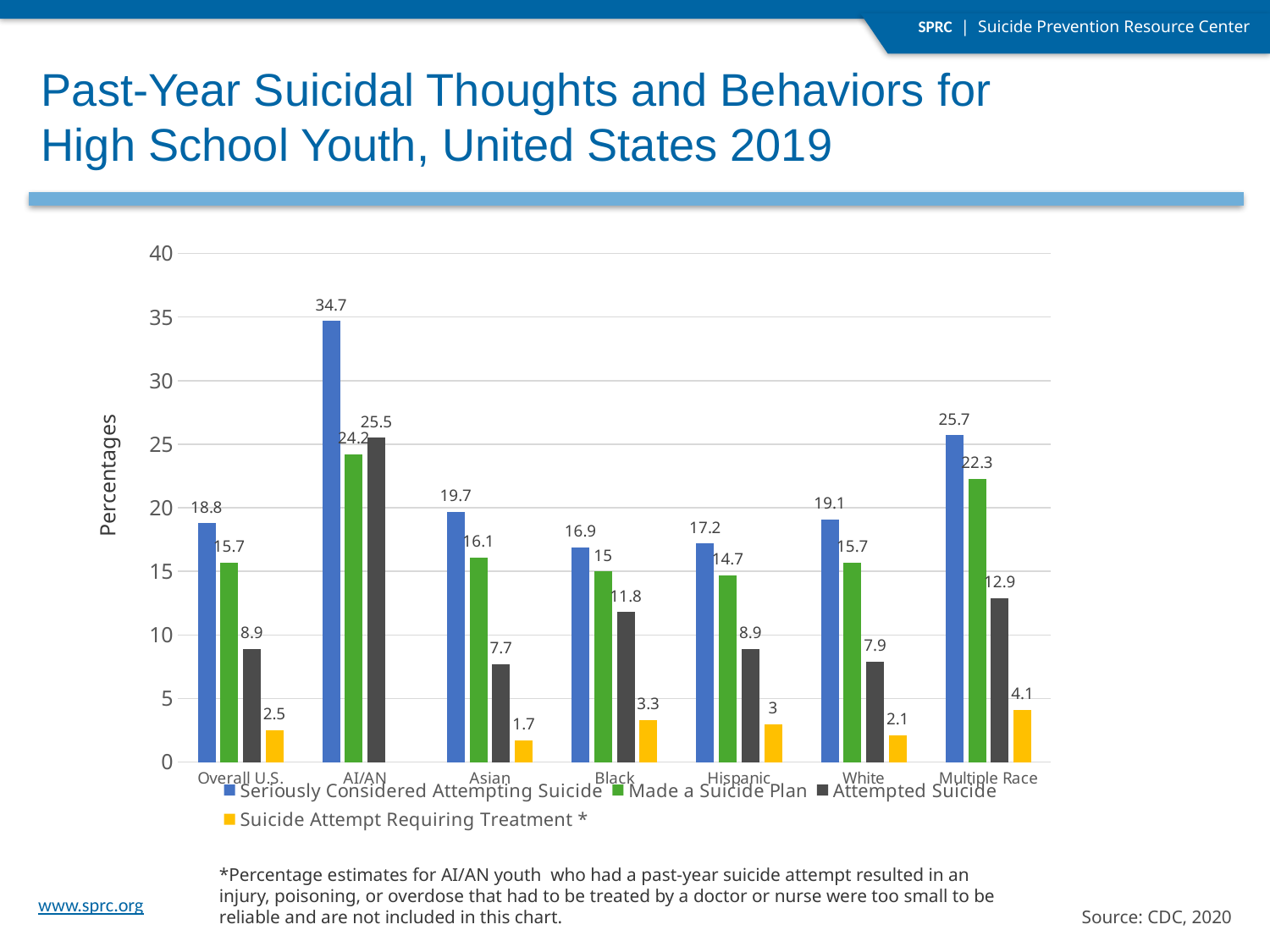
What kind of chart is shown on the slide? Bar chart Which category has the lowest value for Attempted Suicide? Asian How many race/ethnicity categories are shown on the x axis? 7 What is the value for Attempted Suicide for Black youth? 11.8 Which is larger: the Made a Suicide Plan value for Hispanic youth or for White youth? White How many series does the legend list? 4 What is the value for Seriously Considered Attempting Suicide for AI/AN youth? 34.7 What is the value for Suicide Attempt Requiring Treatment for Asian youth? 1.7 What is the difference between the Seriously Considered Attempting Suicide values for AI/AN and Overall U.S.? 15.9 What is the label of the y axis? Percentages Which category has the highest value for Seriously Considered Attempting Suicide? AI/AN What is the value for Made a Suicide Plan for Multiple Race youth? 22.3